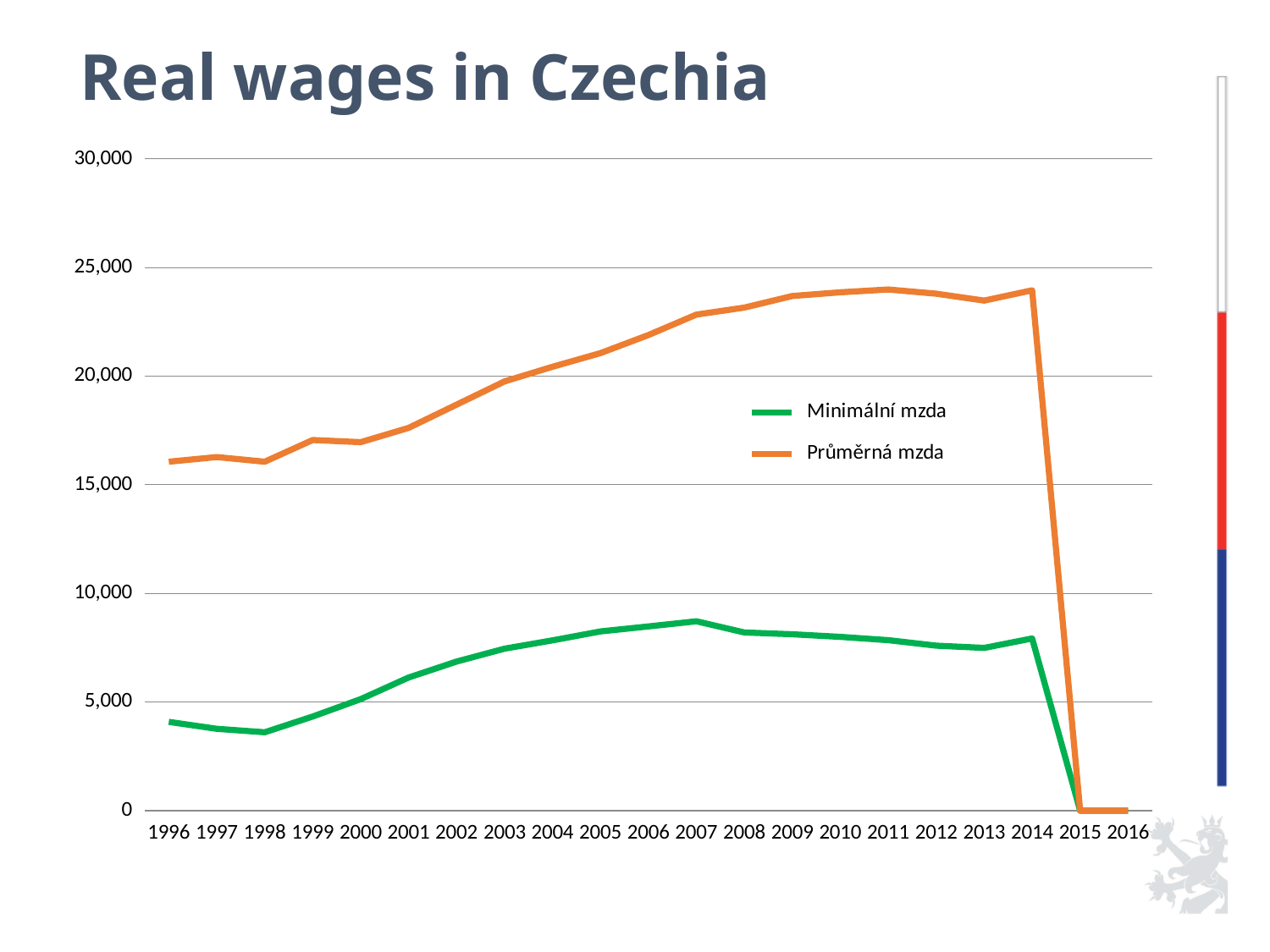
How many series does the legend list? 2 Is the value for Průměrná mzda in 1996 greater or less than 15,000? greater Which colour is used for the Minimální mzda series? green Is the value for Průměrná mzda in 2011 greater or less than 20,000? greater In which year does the Minimální mzda series reach its highest value? 2007 Does the Průměrná mzda series rise or fall from 1996 to 2011? rise In 2010, which series has the larger value, Minimální mzda or Průměrná mzda? Průměrná mzda Is the value for Minimální mzda in 1998 greater or less than 5,000? less What is the title of the chart? Real wages in Czechia What kind of chart is shown on the slide? line chart How many years are shown on the x axis? 21